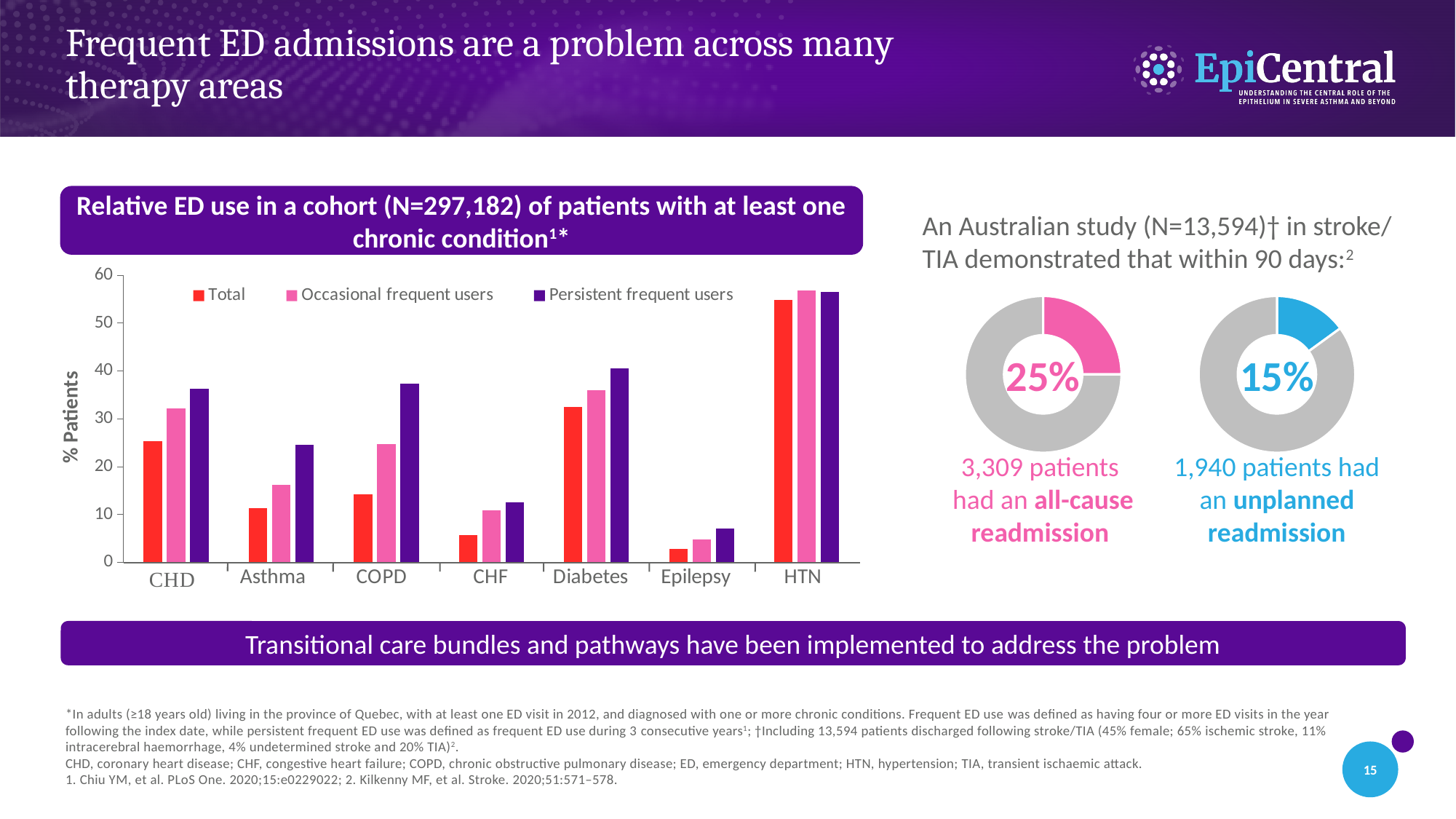
In the bar chart 'Relative ED use in a cohort (N=297,182) of patients with at least one chronic condition', how many chronic conditions are shown on the x axis? 7 What kind of chart is the 'Relative ED use in a cohort' chart on the left of the slide? bar chart In the bar chart 'Relative ED use in a cohort (N=297,182) of patients with at least one chronic condition', how many series does the legend list? 3 In the pink donut chart on the right of the slide, what share of patients had an all-cause readmission? 25% In the bar chart 'Relative ED use in a cohort', which condition has the highest value for Persistent frequent users? HTN In the bar chart 'Relative ED use in a cohort', which is larger for COPD: the Total value or the Persistent frequent users value? Persistent frequent users In the bar chart 'Relative ED use in a cohort', is the Total value for HTN greater or less than 50? greater In the bar chart 'Relative ED use in a cohort', what is the label of the y axis? % Patients In the bar chart 'Relative ED use in a cohort', is the Occasional frequent users value for Diabetes greater or less than 30? greater In the blue donut chart on the right of the slide, what share of patients had an unplanned readmission? 15% In the bar chart 'Relative ED use in a cohort', is the Persistent frequent users value for CHF greater or less than 20? less In the bar chart 'Relative ED use in a cohort', which condition has the lowest value for Total? Epilepsy